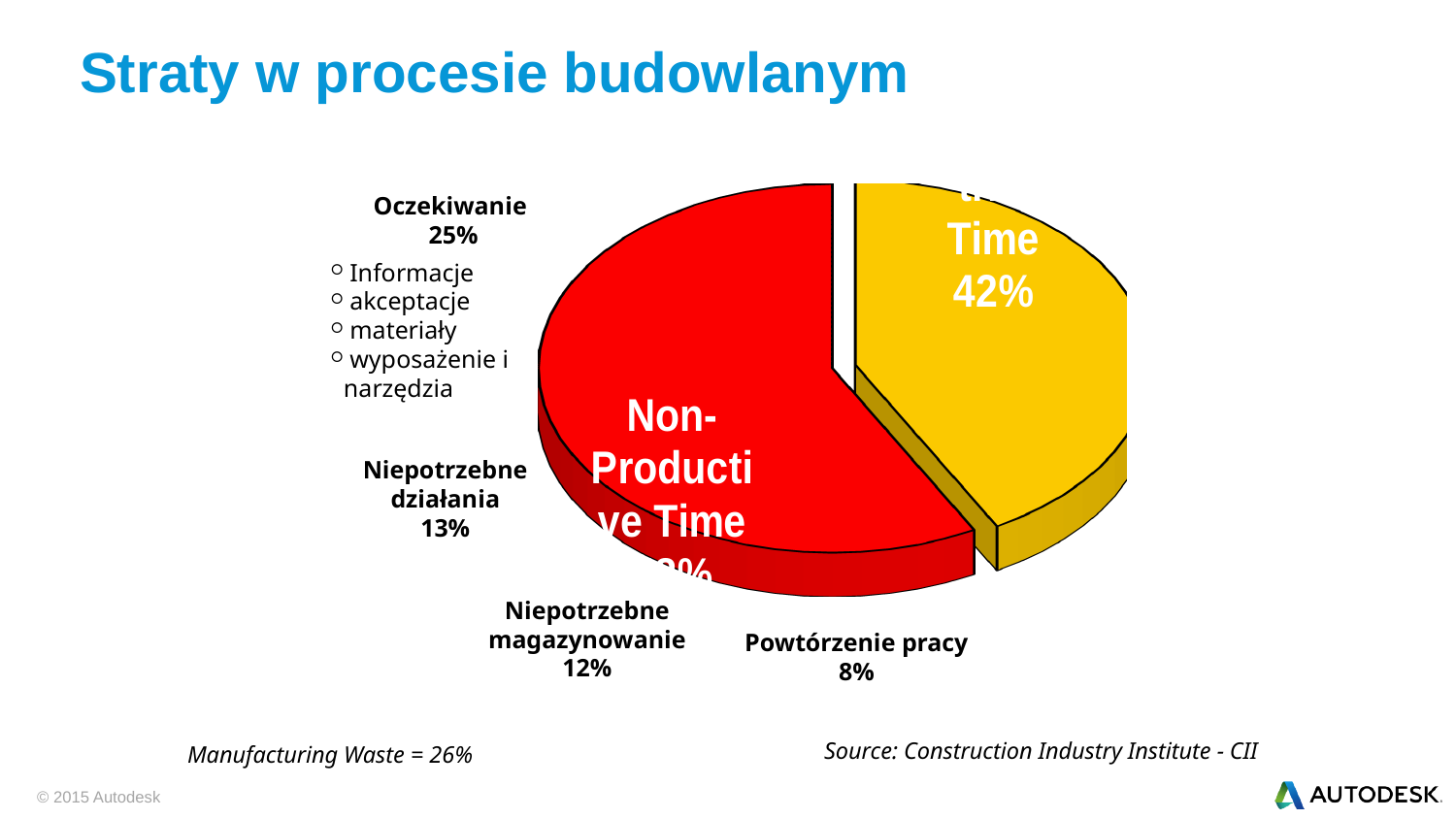
Of the four labelled waste categories (Oczekiwanie, Niepotrzebne działania, Niepotrzebne magazynowanie, Powtórzenie pracy), which has the highest percentage? Oczekiwanie What percentage is given for Niepotrzebne magazynowanie? 12% What percentage is given for Oczekiwanie? 25% What percentage is given for Niepotrzebne działania? 13% How many slices does the pie chart have? 2 Of the four labelled waste categories (Oczekiwanie, Niepotrzebne działania, Niepotrzebne magazynowanie, Powtórzenie pracy), which has the lowest percentage? Powtórzenie pracy What kind of chart is shown on the slide? pie chart What is the title of the slide containing the pie chart? Straty w procesie budowlanym What percentage is given for Powtórzenie pracy? 8% Which slice of the pie chart is larger, the red one or the yellow one? the red one What is the difference between the percentage for Oczekiwanie and the percentage for Powtórzenie pracy? 17% What percentage is printed on the yellow slice of the pie chart? 42%